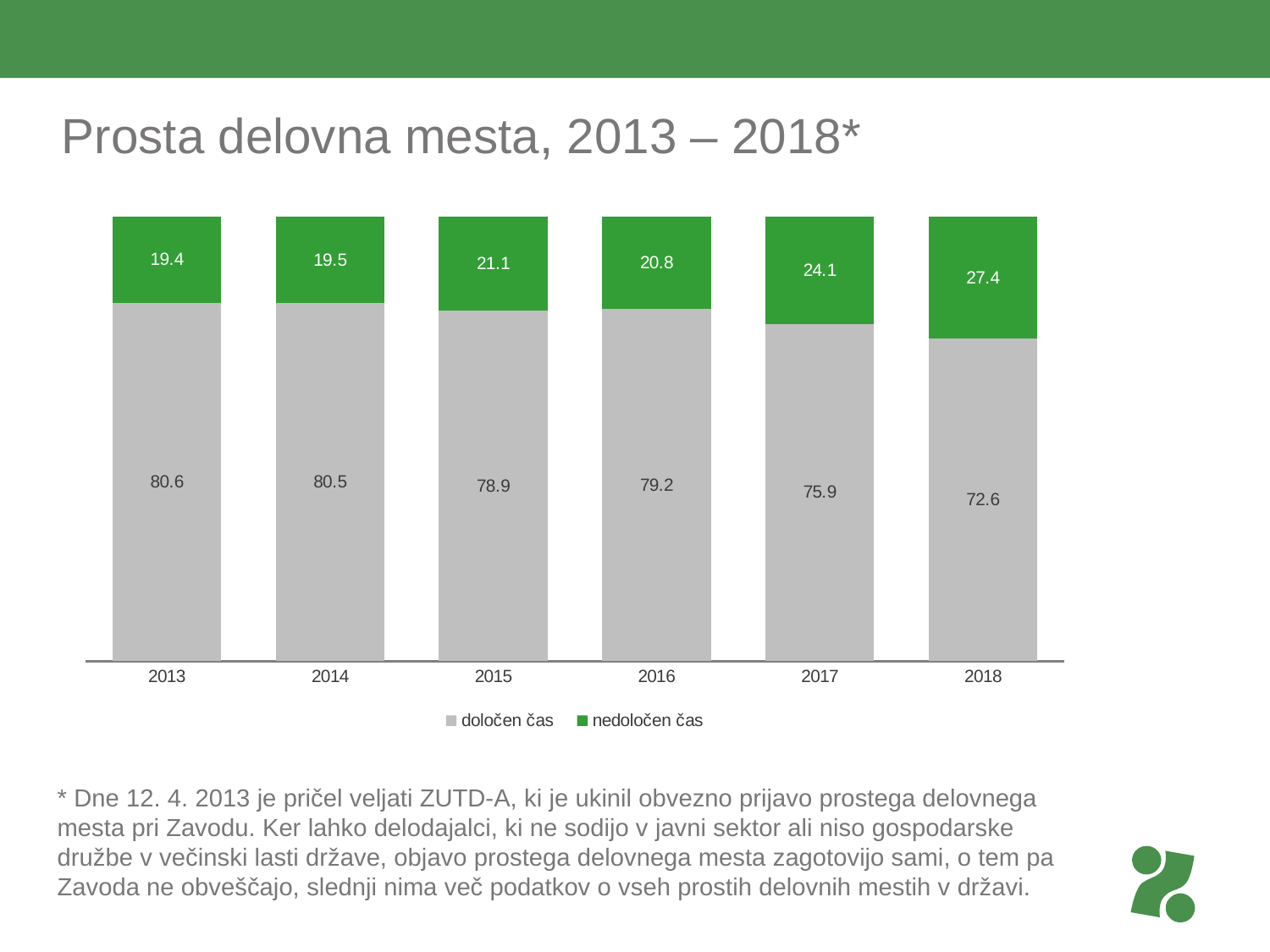
Does the value for "nedoločen čas" rise or fall from 2016 to 2018? rise How many years are shown on the x axis? 6 How many series does the legend list? 2 Which year has the lowest value for "določen čas"? 2018 What is the title of the chart? Prosta delovna mesta, 2013 – 2018* What is the value for "določen čas" in 2013? 80.6 What is the difference between the "določen čas" values for 2013 and 2018? 8 What kind of chart is shown on the slide? stacked bar chart What is the value for "nedoločen čas" in 2016? 20.8 Which is larger, the "nedoločen čas" value for 2015 or for 2017? 2017 Which year has the highest value for "nedoločen čas"? 2018 What is the value for "nedoločen čas" in 2018? 27.4